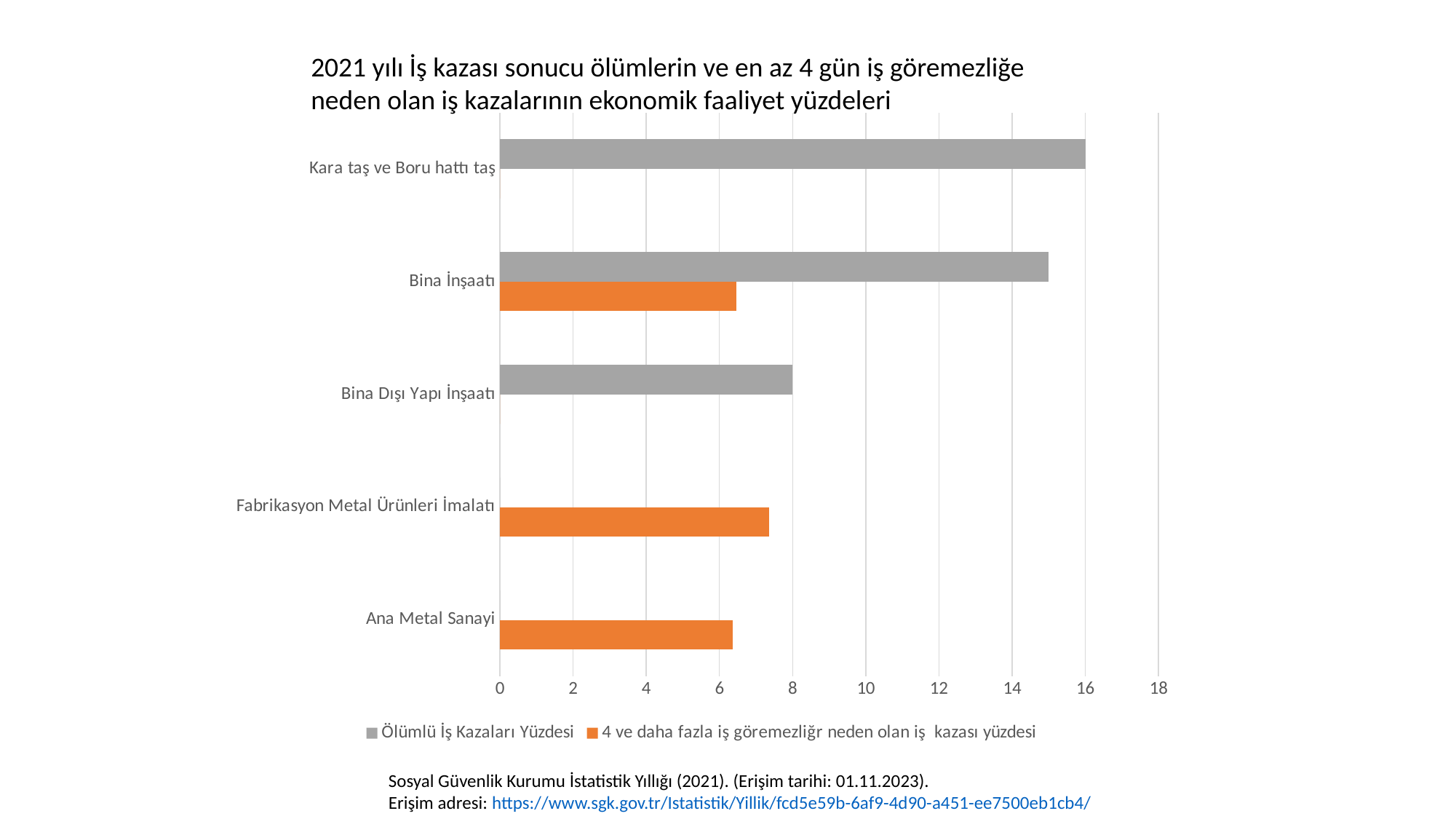
Is the orange-series value for Ana Metal Sanayi greater or less than 6? greater For Bina İnşaatı, which series has the larger value: Ölümlü İş Kazaları Yüzdesi or the orange series? Ölümlü İş Kazaları Yüzdesi How many series does the legend list? 2 What kind of chart is shown on the slide? Bar chart What is the value of Ölümlü İş Kazaları Yüzdesi for Bina Dışı Yapı İnşaatı? 8 Which category has the highest value for the orange series (4 ve daha fazla iş göremezliğe neden olan iş kazası yüzdesi)? Fabrikasyon Metal Ürünleri İmalatı Which category has the highest Ölümlü İş Kazaları Yüzdesi? Kara taş ve Boru hattı taş Is the Ölümlü İş Kazaları Yüzdesi value for Bina İnşaatı greater or less than 14? greater What is the difference between the Ölümlü İş Kazaları Yüzdesi values for Kara taş ve Boru hattı taş and Bina Dışı Yapı İnşaatı? 8 How many categories are shown on the vertical axis? 5 What is the value of Ölümlü İş Kazaları Yüzdesi for Kara taş ve Boru hattı taş? 16 Is the orange-series value for Fabrikasyon Metal Ürünleri İmalatı greater or less than 8? less